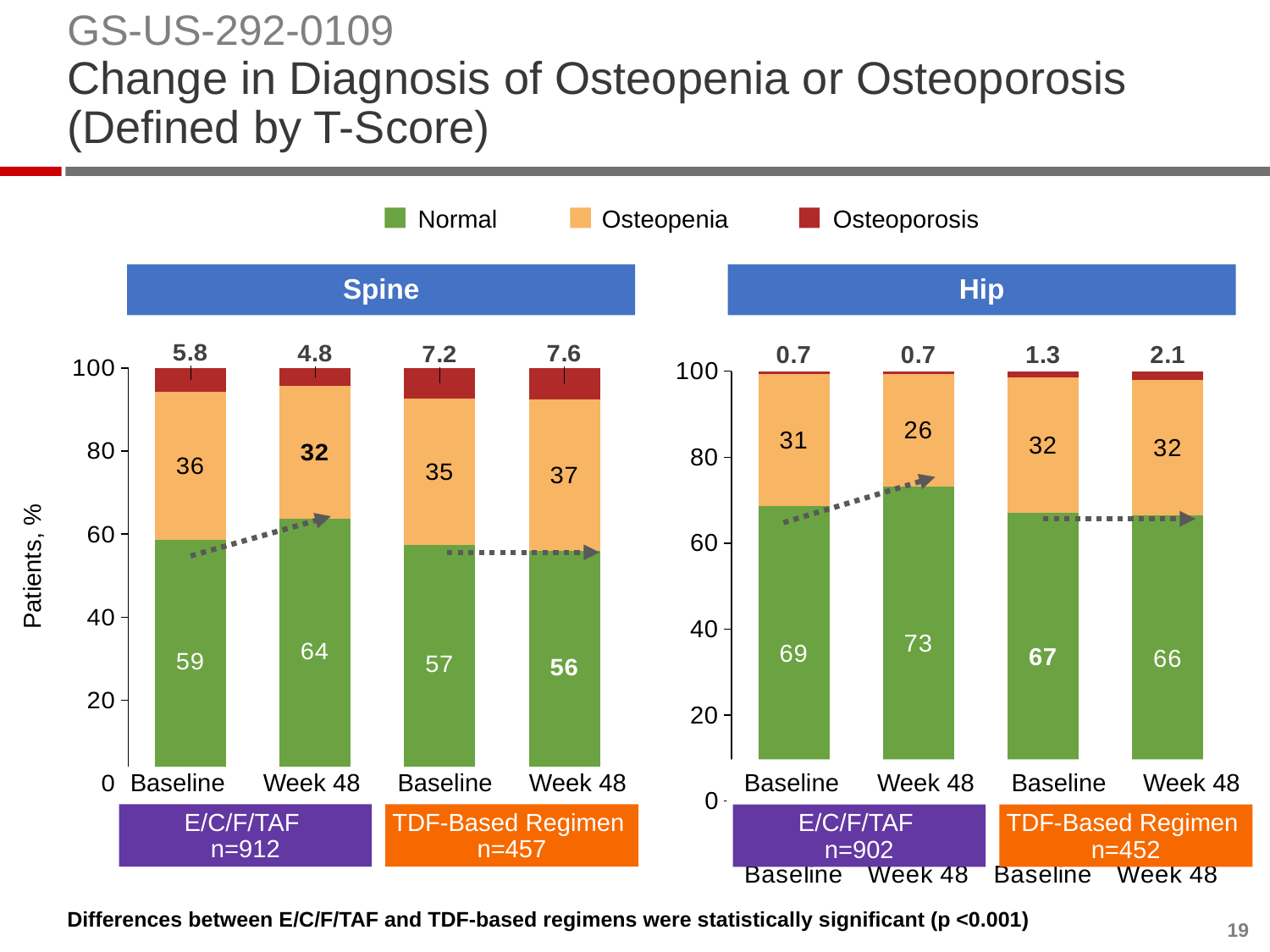
How many series does the legend list? 3 In the Hip chart, which is larger: the Normal value for E/C/F/TAF at Week 48 or for the TDF-Based Regimen at Week 48? E/C/F/TAF at Week 48 In the Hip chart, what is the Osteoporosis value for the TDF-Based Regimen at Baseline? 1.3 In the Spine chart, what is the Normal value for E/C/F/TAF at Week 48? 64 In the Spine chart, which bar has the lowest Osteopenia value? E/C/F/TAF Week 48 In the Hip chart, what is the Osteopenia value for E/C/F/TAF at Week 48? 26 In the Hip chart, which bar has the highest Normal value? E/C/F/TAF Week 48 In the Spine chart, what is the Osteoporosis value for the TDF-Based Regimen at Week 48? 7.6 What kind of chart is the Spine chart? Stacked bar chart In the Spine chart, does the Normal value for the TDF-Based Regimen rise or fall from Baseline to Week 48? Fall What is the y-axis label of the Spine chart? Patients, % In the Spine chart, what is the difference in the Normal value between Baseline and Week 48 for E/C/F/TAF? 5